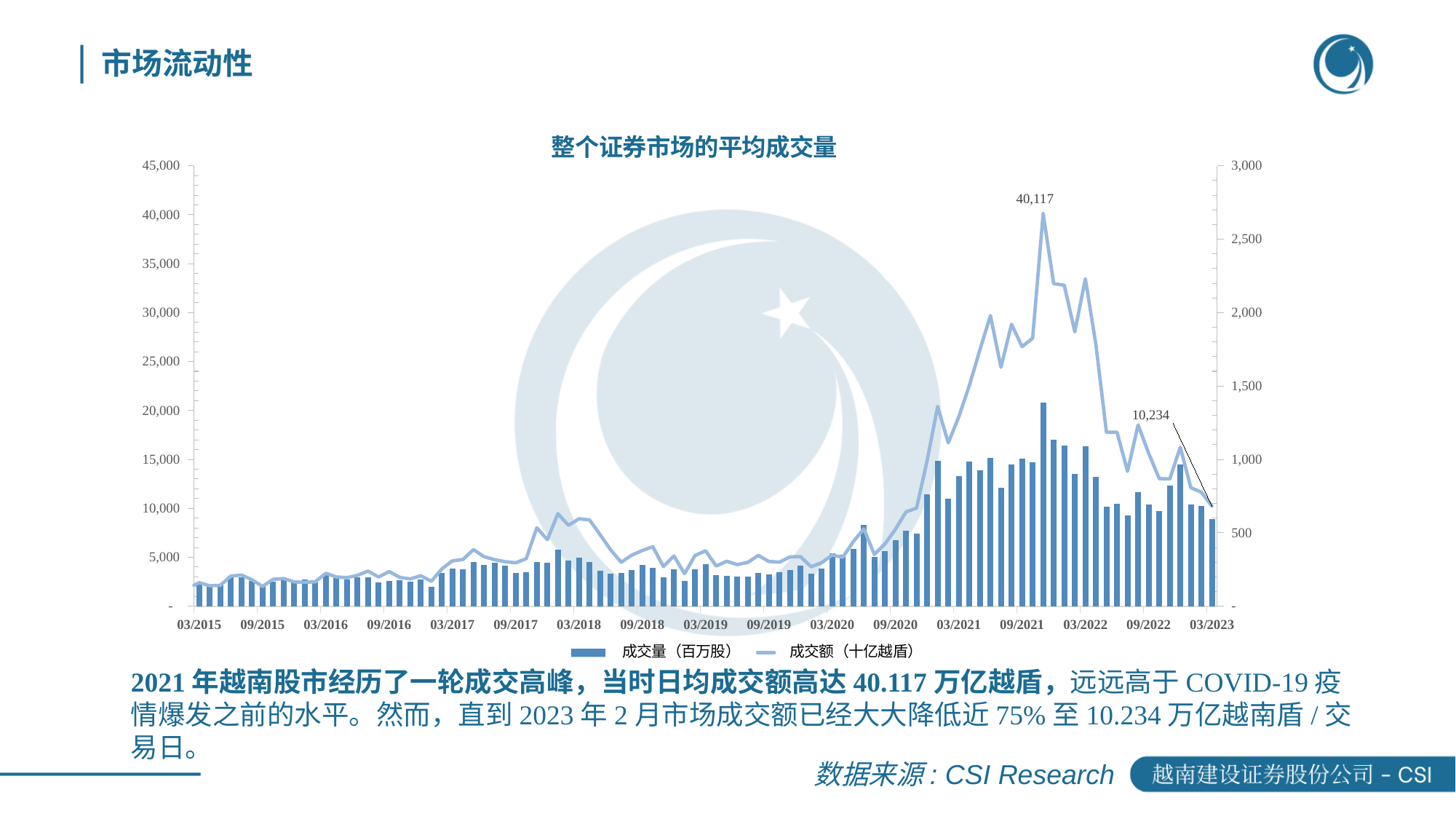
How many series does the chart legend list? 2 Which series is plotted as bars? 成交量（百万股） What is the title of the chart? 整个证券市场的平均成交量 Is the 成交量 bar for 03/2015 greater or less than 5,000 on the left axis? less Does the 成交额 line rise or fall between 03/2022 and 03/2023? fall What is the value labelled near the end of the 成交额 line (pointing to 03/2023)? 10,234 Which labelled value on the 成交额 line is larger, the peak in 2021 or the value at 03/2023? The peak in 2021 (40,117) Is the tallest 成交量 bar greater or less than 15,000 on the left axis? greater What kind of chart is shown on the slide? Combined bar and line chart What is the maximum value shown on the right-hand axis? 3,000 What is the peak value labelled on the 成交额 line? 40,117 What is the difference between the two labelled values on the 成交额 line, 40,117 and 10,234? 29,883